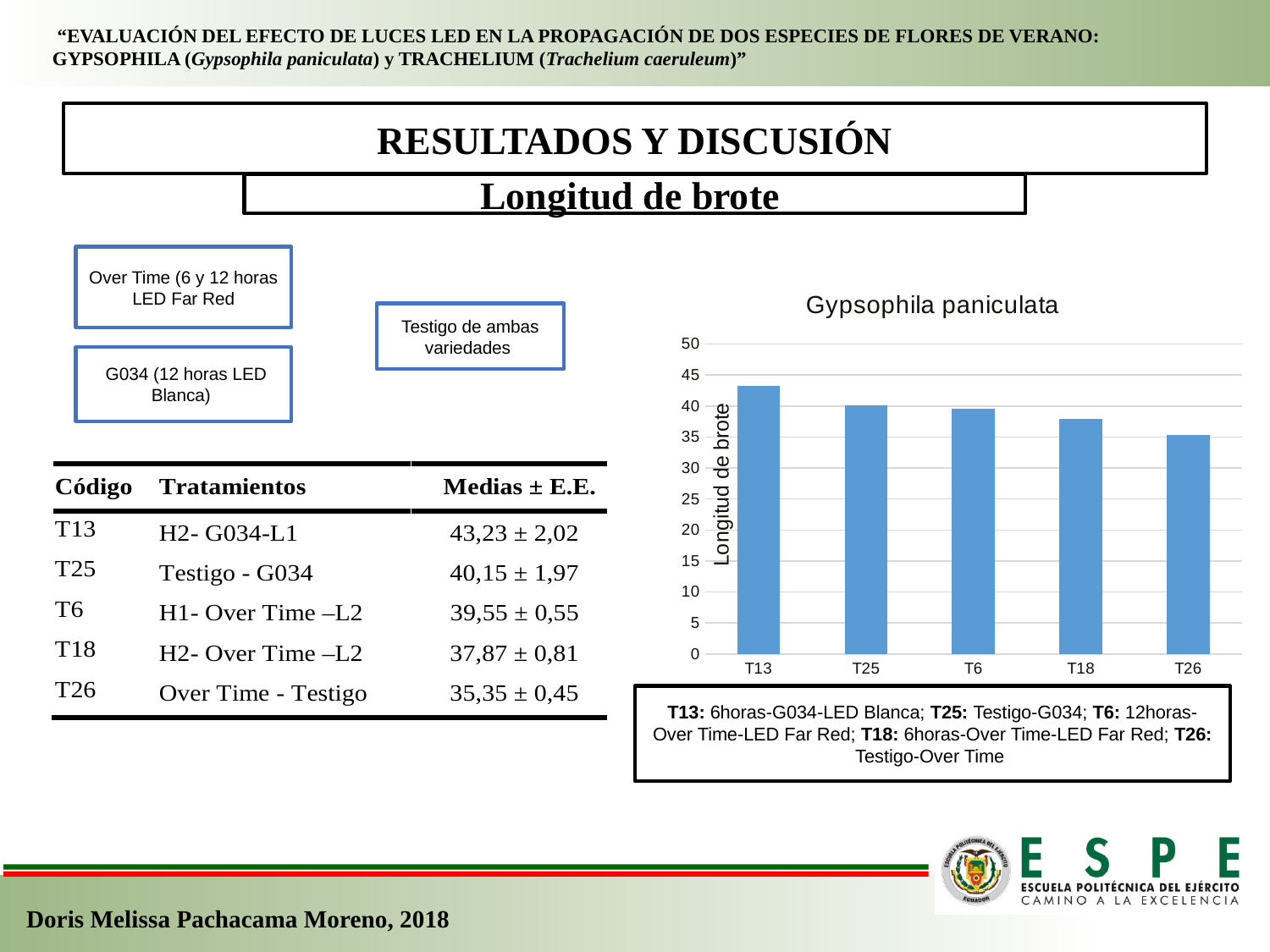
What is the title of the chart? Gypsophila paniculata Do the bar values rise or fall from T13 to T26 along the x axis? fall Is the value for T26 greater or less than 40? less Is the value for T18 greater or less than 40? less Is the value for T13 greater or less than 40? greater Which treatment has the shortest bar in the chart? T26 What is the label on the vertical axis of the chart? Longitud de brote Which bar is taller, T18 or T26? T18 How many treatment categories are plotted on the x axis of the chart? 5 What kind of chart is shown on the slide? bar chart Which treatment has the tallest bar in the chart? T13